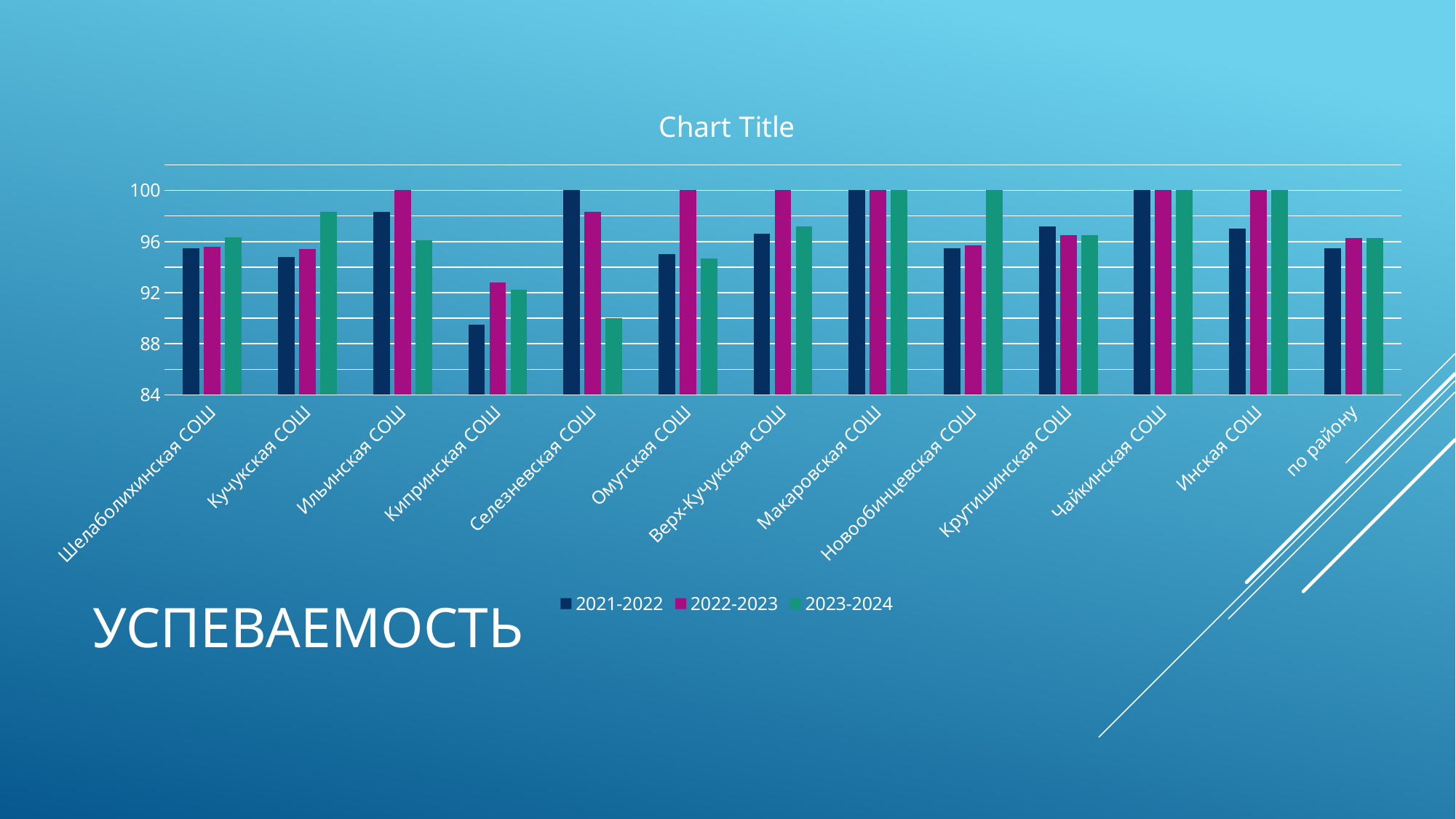
Is the value for Селезневская СОШ in 2023-2024 greater or less than 88? greater How many series does the legend list? 3 Is the value for Кипринская СОШ in 2022-2023 greater or less than 92? greater How many categories are shown on the x axis? 13 What are the legend entries of the chart? 2021-2022, 2022-2023, 2023-2024 Which category has the lowest value in the 2021-2022 series? Кипринская СОШ What is the value for Чайкинская СОШ in 2023-2024? 100 What is the value for Селезневская СОШ in 2021-2022? 100 Is the value for Кипринская СОШ in 2021-2022 greater or less than 92? less What kind of chart is shown on the slide? bar chart Which is larger for 2021-2022: Кипринская СОШ or Селезневская СОШ? Селезневская СОШ What is the value for Макаровская СОШ in 2021-2022? 100